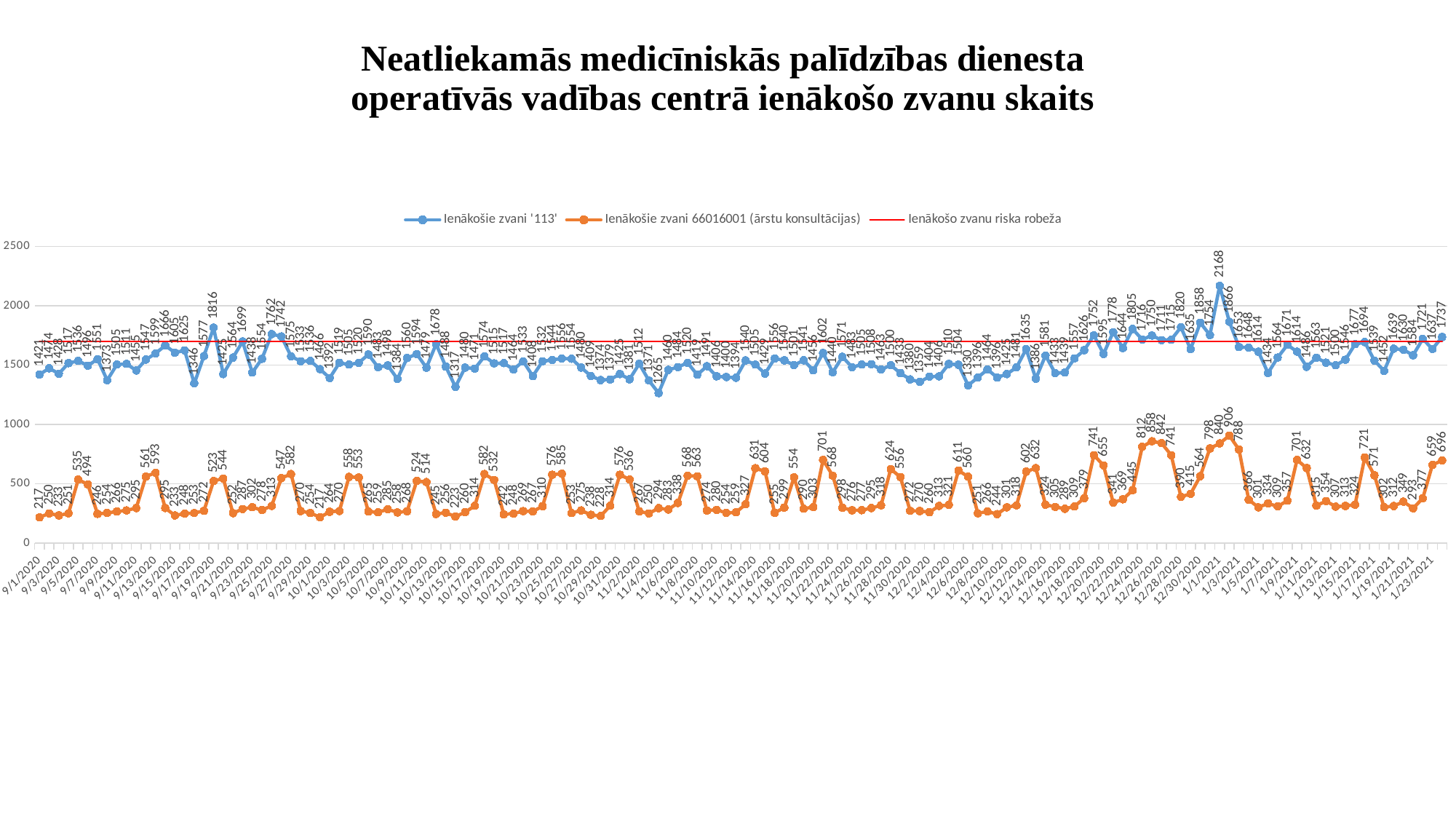
How many series does the legend list? 3 Is the peak value of the 'Ienākošie zvani 66016001 (ārstu konsultācijas)' series greater or less than 1000? less Which series has higher values throughout the whole period, 'Ienākošie zvani '113'' or 'Ienākošie zvani 66016001 (ārstu konsultācijas)'? Ienākošie zvani '113' What does the red horizontal line in the chart represent, according to the legend? Ienākošo zvanu riska robeža What kind of chart is shown on the slide? line chart Does the 'Ienākošie zvani 66016001 (ārstu konsultācijas)' series end higher or lower than it starts? higher What is the highest value reached by the 'Ienākošie zvani 66016001 (ārstu konsultācijas)' series? 906 What is the lowest value of the 'Ienākošie zvani '113'' series? 1265 What is the difference between the peak of the '113' series (2168) and the peak of the 66016001 series (906)? 1262 What is the highest value reached by the 'Ienākošie zvani '113'' series? 2168